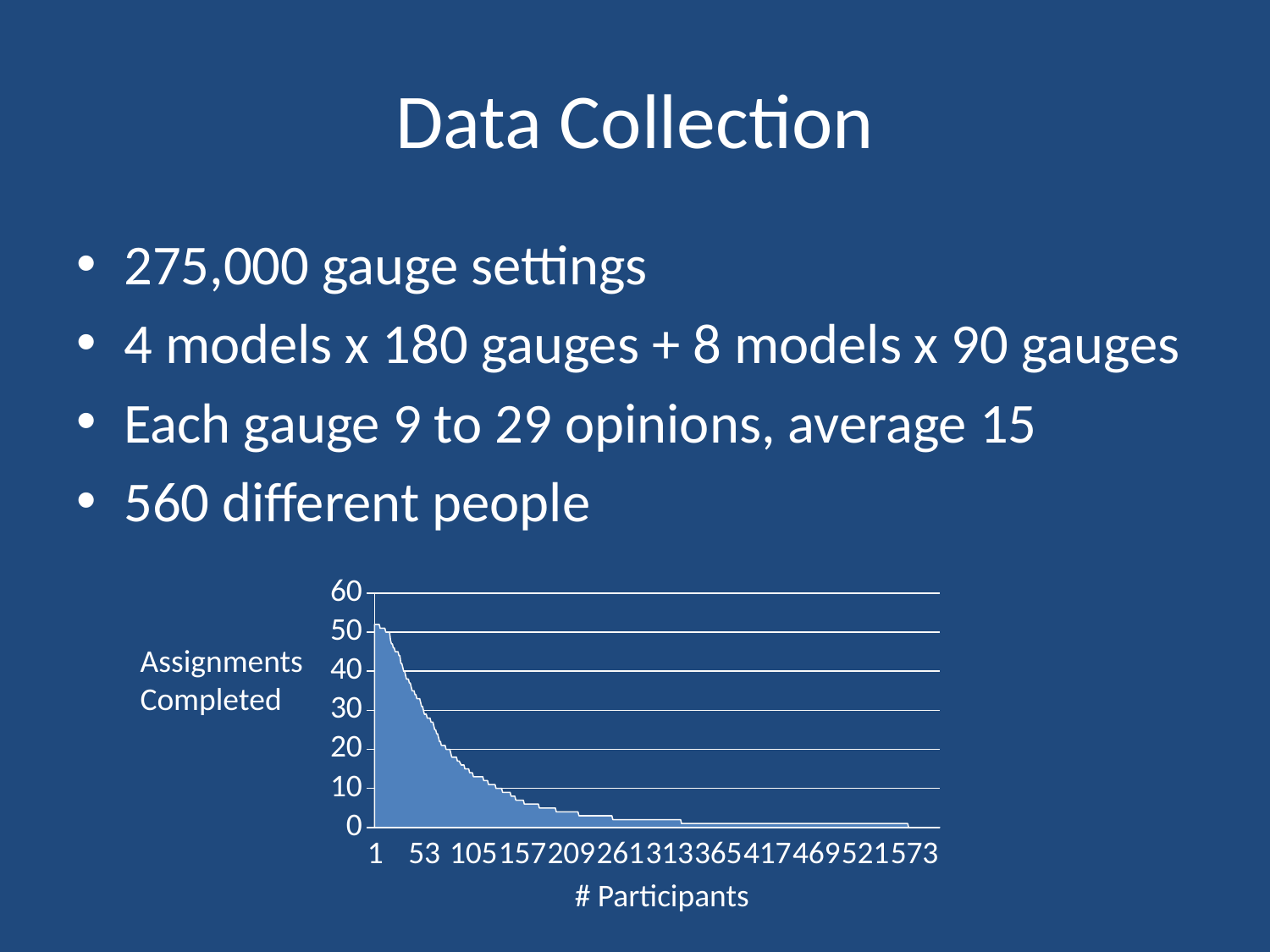
What kind of chart is shown on the slide? area chart Is the value for participant 105 greater or less than 20? less Is the value for participant 1 greater or less than 40? greater Which participant number on the x axis has the highest number of assignments completed? 1 How many tick labels are shown on the x axis of the chart? 12 What is the label of the x axis of the chart? # Participants Do the values in the chart rise or fall as the participant number increases along the x axis? fall Is the value for participant 573 greater or less than 10? less What is the highest value shown on the y axis of the chart? 60 Which is larger, the value for participant 53 or the value for participant 313? participant 53